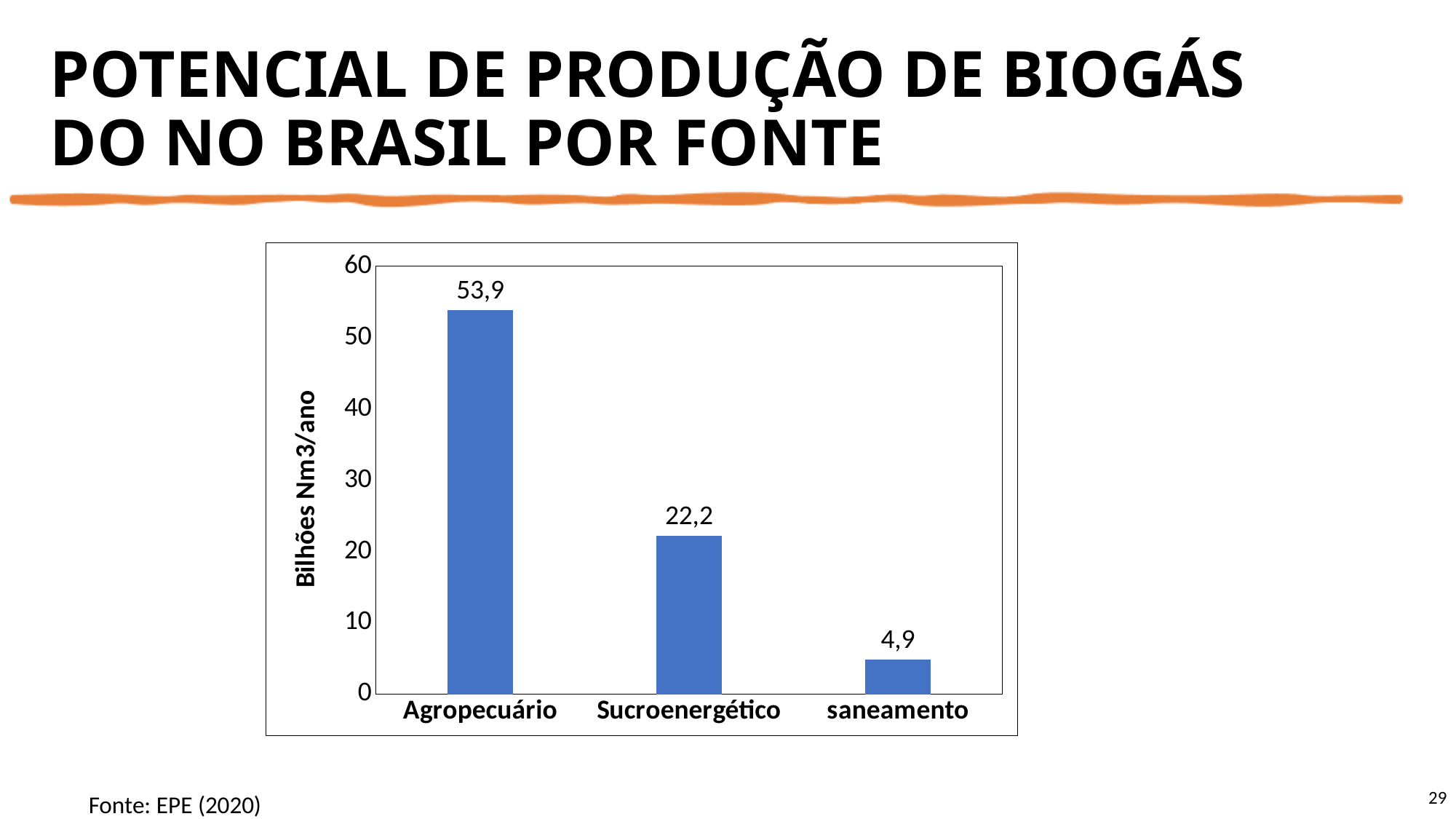
Which category has the lowest value? saneamento Which is larger, the value for Sucroenergético or the value for saneamento? Sucroenergético What is the value for Agropecuário? 53,9 What is the value for Sucroenergético? 22,2 What is the label of the vertical axis? Bilhões Nm3/ano What is the difference between the values for Agropecuário and Sucroenergético? 31,7 What kind of chart is shown on the slide? bar chart Which category has the highest value? Agropecuário What is the value for saneamento? 4,9 How many categories are shown on the x axis? 3 Is the value for Agropecuário greater or less than 50? greater What is the difference between the values for Sucroenergético and saneamento? 17,3